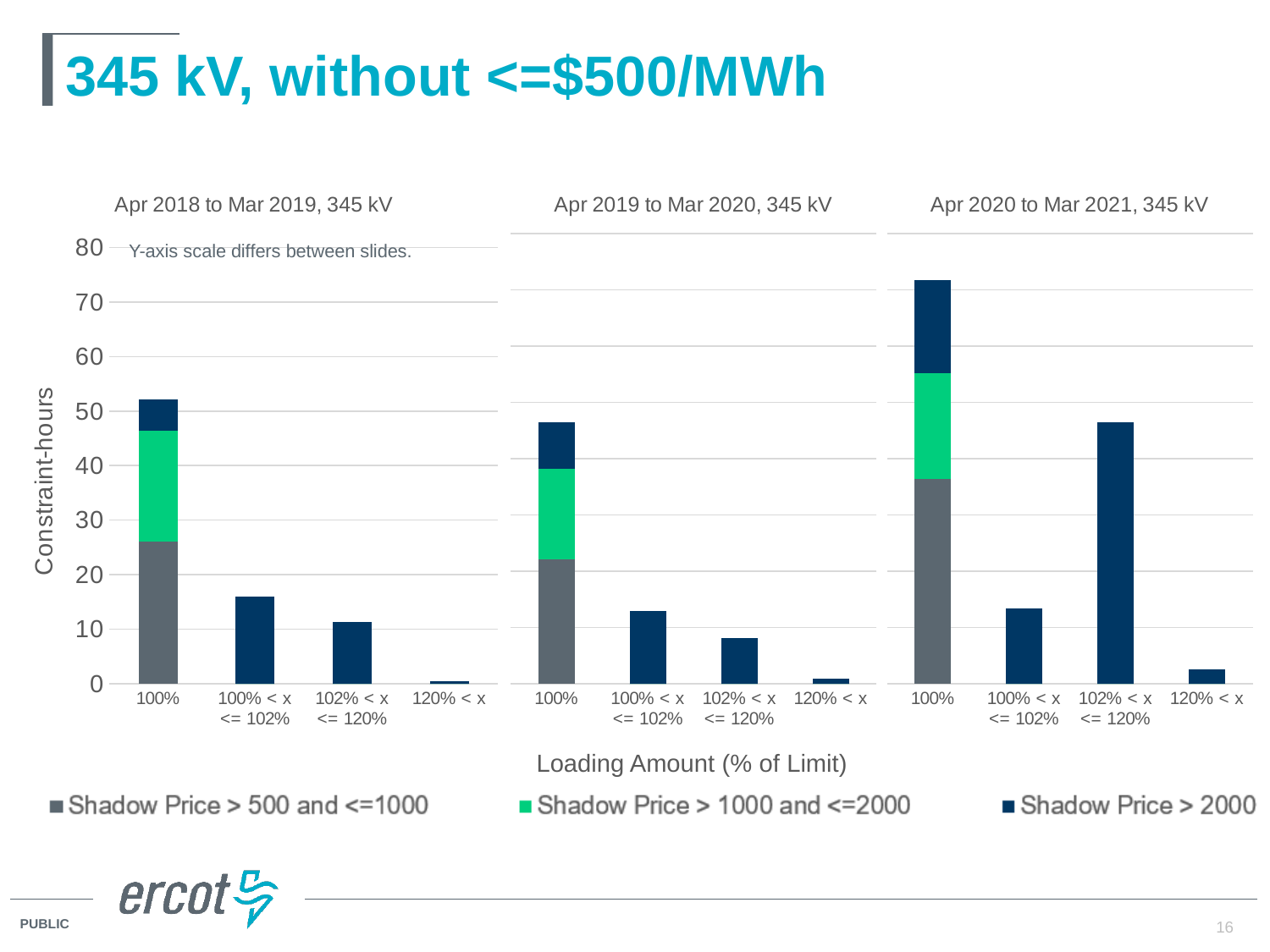
In the Apr 2019 to Mar 2020, 345 kV chart, is the total value for the 100% category greater or less than 40? greater What kind of chart is used on this slide? Stacked bar chart In the Apr 2018 to Mar 2019, 345 kV chart, which is larger: the value for 100% < x <= 102% or the value for 102% < x <= 120%? 100% < x <= 102% How many series does the legend list? 3 In the Apr 2020 to Mar 2021, 345 kV chart, is the value for the 102% < x <= 120% category greater or less than 40? greater In the Apr 2020 to Mar 2021, 345 kV chart, is the total value for the 100% category greater or less than 70? greater In the Apr 2018 to Mar 2019, 345 kV chart, how many loading amount categories are shown on the x axis? 4 In the Apr 2019 to Mar 2020, 345 kV chart, which loading amount category has the lowest total constraint-hours? 120% < x In the Apr 2020 to Mar 2021, 345 kV chart, which loading amount category has the highest total constraint-hours? 100% What is the label of the y axis? Constraint-hours In the Apr 2018 to Mar 2019, 345 kV chart, do the total constraint-hours rise or fall moving from left to right along the x axis? fall